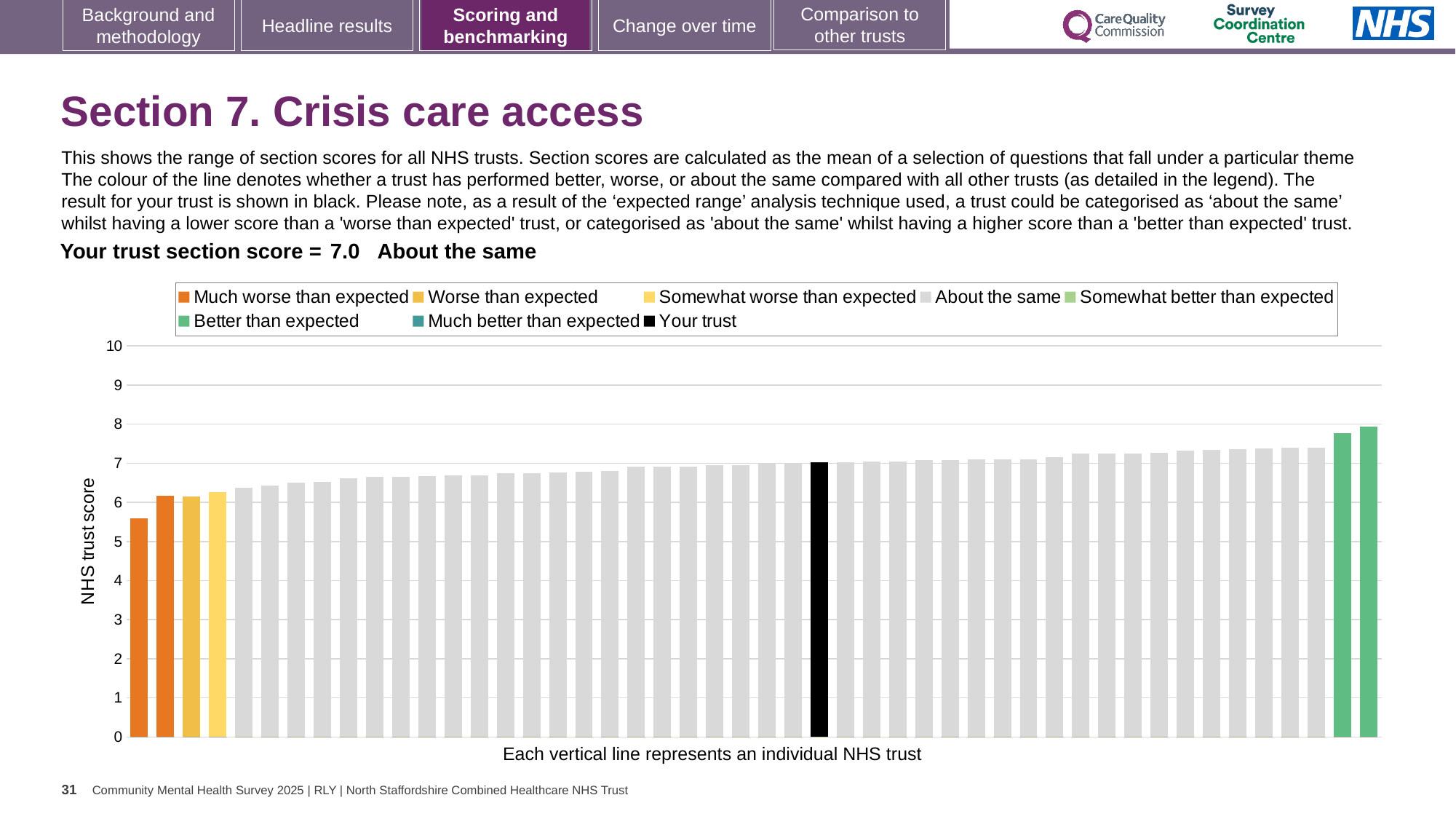
How many bars on the chart are coloured orange (Much worse than expected)? 2 Is the value for the rightmost (highest) bar greater or less than 7? greater Is the value for the leftmost (lowest) bar greater or less than 6? less How many entries does the chart legend list? 8 Which is larger: the value of the black 'Your trust' bar or the value of the leftmost orange bar? the black 'Your trust' bar Which is larger: the value of the black 'Your trust' bar or the value of the rightmost green bar? the rightmost green bar What kind of chart is shown on the slide? bar chart Is the value for the black 'Your trust' bar greater or less than 5? greater Do the bar values rise or fall from left to right along the x axis? rise According to the legend, what does a black bar represent? Your trust What is the label on the vertical axis of the chart? NHS trust score What is the section score for your trust shown on the slide? 7.0